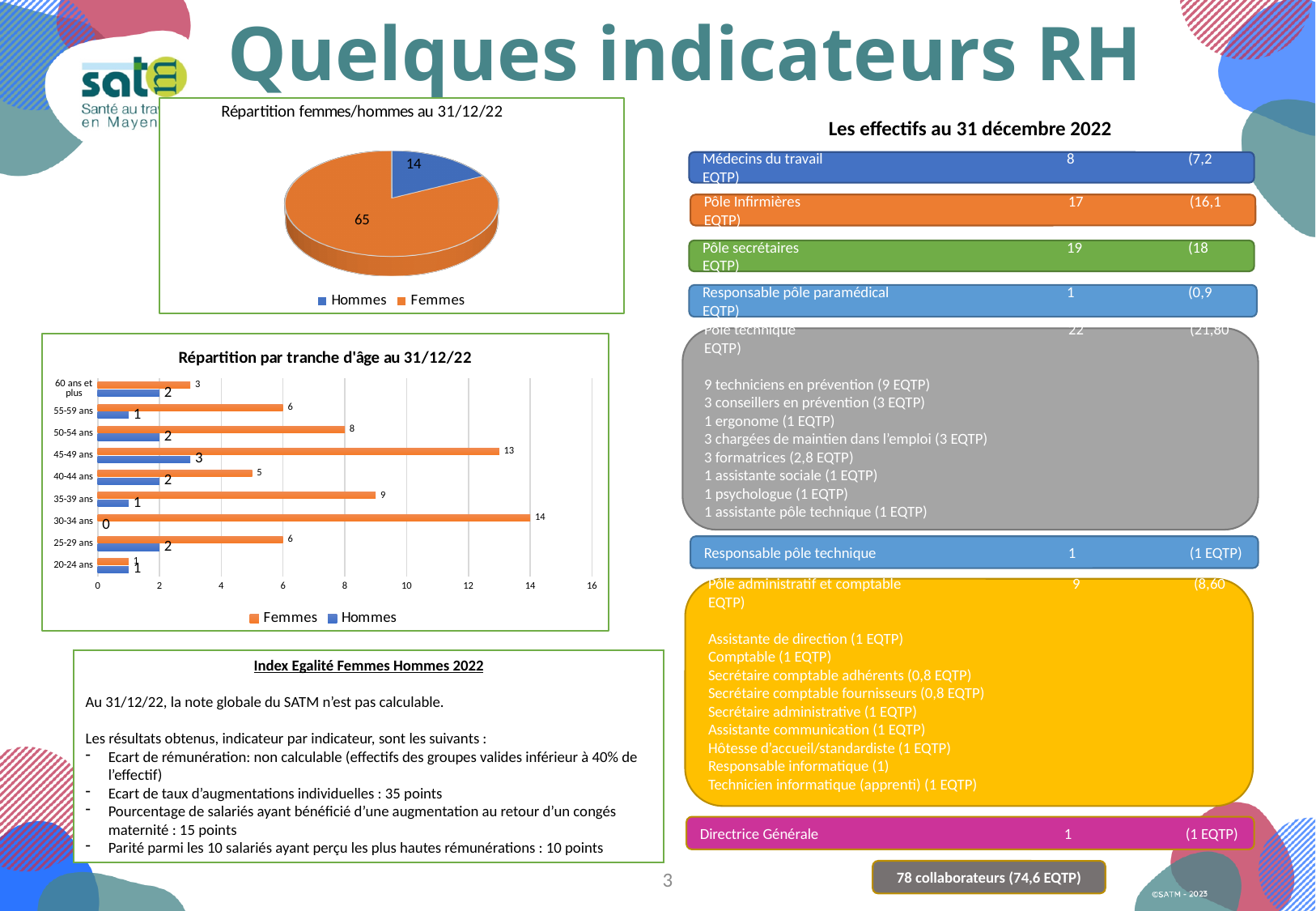
In the bar chart 'Répartition par tranche d'âge au 31/12/22', which age category has the lowest Hommes value? 30-34 ans In the bar chart 'Répartition par tranche d'âge au 31/12/22', how many age categories are shown? 9 In the bar chart 'Répartition par tranche d'âge au 31/12/22', what is the difference between the Femmes and Hommes values for 50-54 ans? 6 What kind of chart is 'Répartition par tranche d'âge au 31/12/22'? Bar chart In the bar chart 'Répartition par tranche d'âge au 31/12/22', what is the Femmes value for 30-34 ans? 14 In the bar chart 'Répartition par tranche d'âge au 31/12/22', how many series does the legend list? 2 In the pie chart 'Répartition femmes/hommes au 31/12/22', what is the value for Hommes? 14 In the pie chart 'Répartition femmes/hommes au 31/12/22', what is the total of the two slices? 79 In the bar chart 'Répartition par tranche d'âge au 31/12/22', which age category has the highest Femmes value? 30-34 ans In the pie chart 'Répartition femmes/hommes au 31/12/22', what is the difference between Femmes and Hommes? 51 In the bar chart 'Répartition par tranche d'âge au 31/12/22', what is the Hommes value for 45-49 ans? 3 In the pie chart 'Répartition femmes/hommes au 31/12/22', what is the value for Femmes? 65